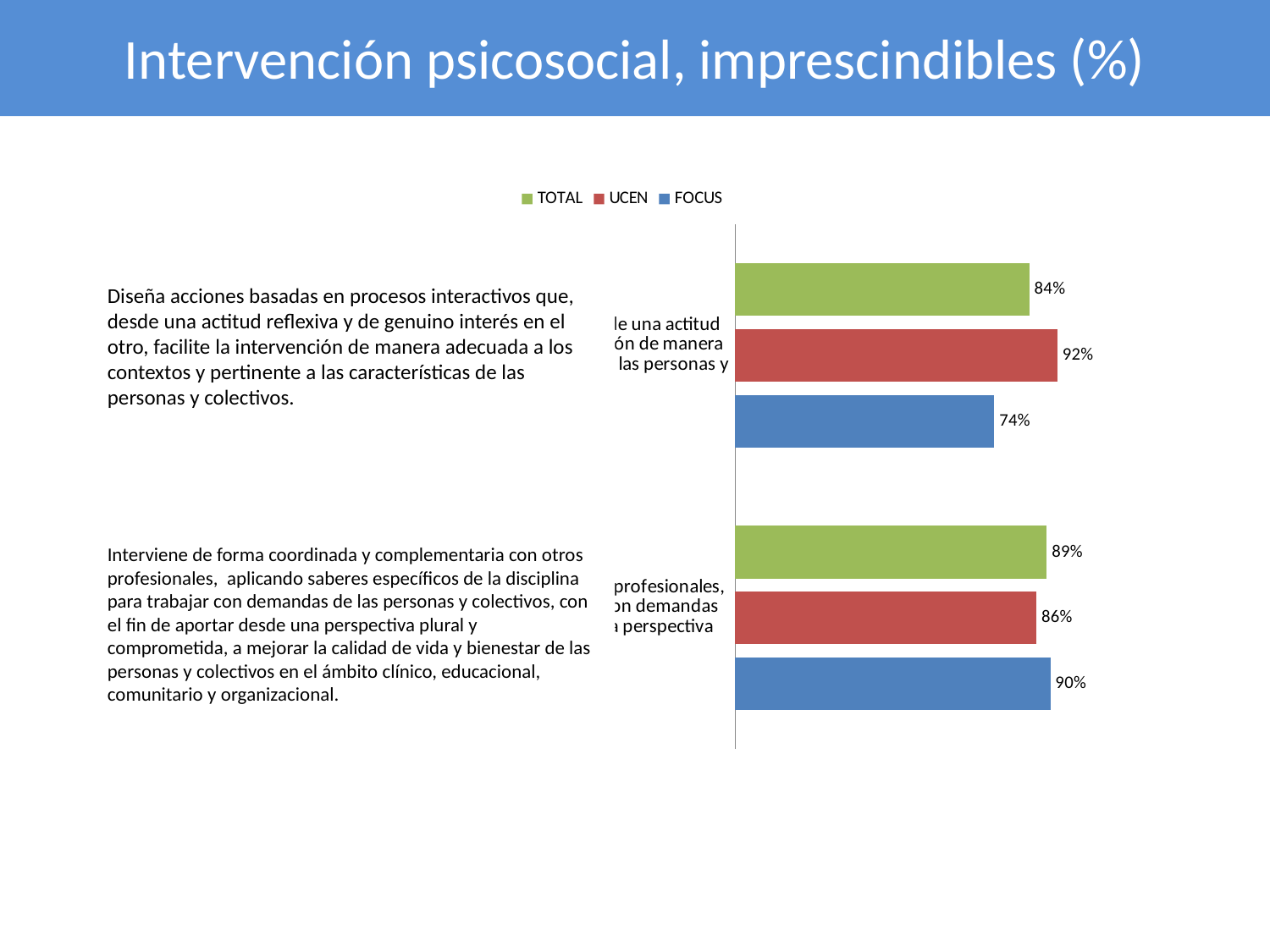
What kind of chart is shown on the slide? Bar chart Which is larger: the FOCUS value for "Diseña acciones basadas en procesos interactivos..." or the FOCUS value for "Interviene de forma coordinada y complementaria..."? Interviene de forma coordinada y complementaria Which colour represents the UCEN series in the chart? Red What is the difference between the TOTAL values of the two categories? 5% What is the UCEN value for the category "Diseña acciones basadas en procesos interactivos..."? 92% What is the difference between the UCEN and FOCUS values for the category "Diseña acciones basadas en procesos interactivos..."? 18% How many series does the legend list? 3 What is the TOTAL value for the category "Interviene de forma coordinada y complementaria con otros profesionales..."? 89% What is the FOCUS value for the category "Diseña acciones basadas en procesos interactivos..."? 74% What is the FOCUS value for the category "Interviene de forma coordinada y complementaria con otros profesionales..."? 90% Which series has the lowest value for the category "Interviene de forma coordinada y complementaria con otros profesionales..."? UCEN Which series has the highest value for the category "Diseña acciones basadas en procesos interactivos..."? UCEN